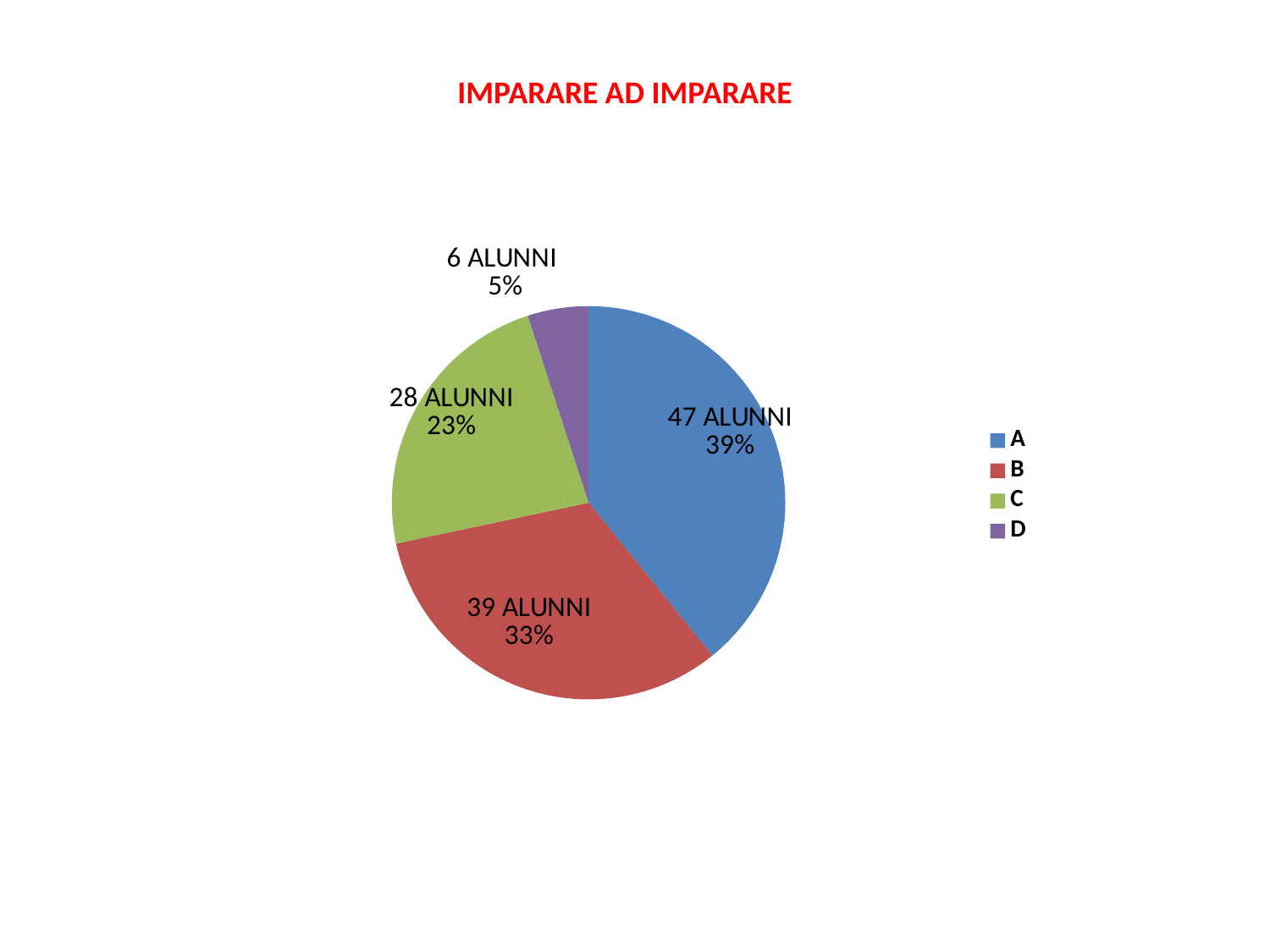
Which category has the smallest slice? D Which category has more alunni, B or C? B How many alunni are in category C? 28 ALUNNI How many entries does the legend list? 4 How many slices does the pie chart have? 4 What is the title of the chart? IMPARARE AD IMPARARE What kind of chart is shown on the slide? pie chart Which category has the largest slice? A What is the difference in number of alunni between category A and category B? 8 What percentage share does category B have? 33% How many alunni are in category A? 47 ALUNNI What percentage share does category D have? 5%